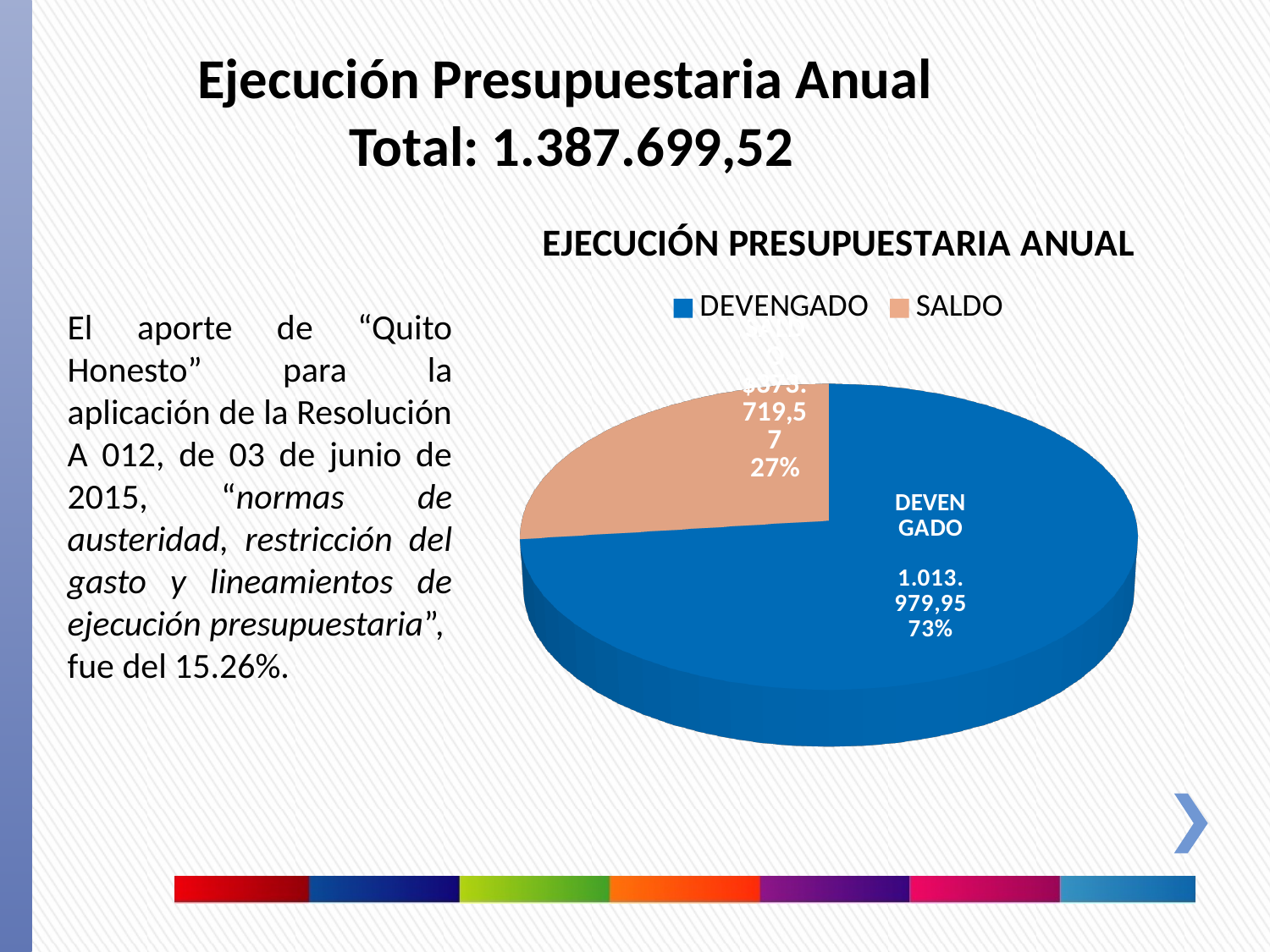
What percentage of the pie does SALDO represent? 27% What is the difference in percentage points between the DEVENGADO and SALDO shares? 46 Which slice is the largest in the pie chart? DEVENGADO Which slice is the smallest in the pie chart? SALDO What colour is the DEVENGADO slice in the pie chart? blue How many entries does the chart legend list? 2 What is the value shown for DEVENGADO? 1.013.979,95 What kind of chart is shown on the slide? pie chart What percentage of the pie does DEVENGADO represent? 73% What is the title of the chart? EJECUCIÓN PRESUPUESTARIA ANUAL Which is larger, DEVENGADO or SALDO? DEVENGADO How many slices does the pie chart have? 2